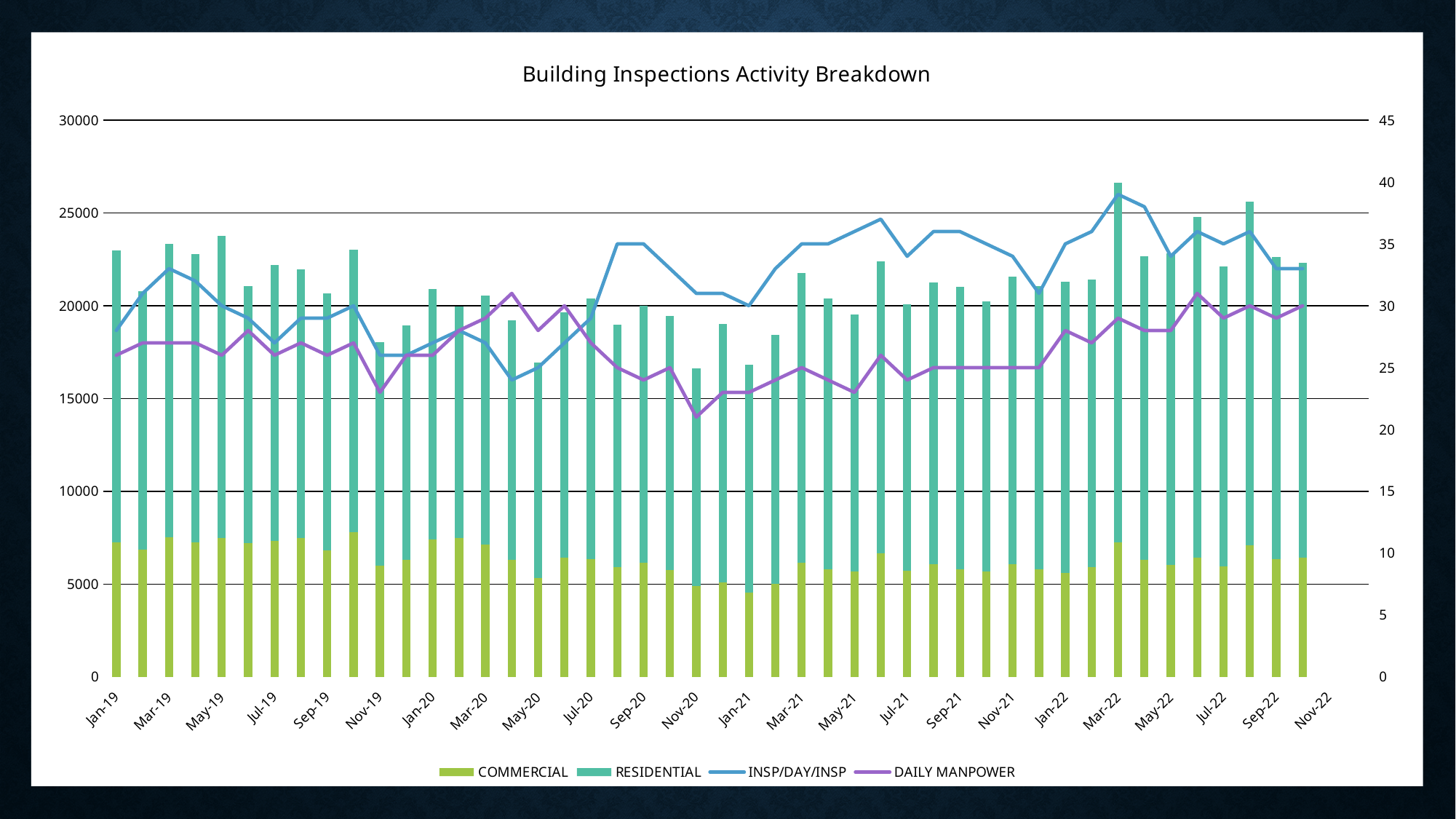
Which has the larger total stacked bar, Jan-19 or Mar-22? Mar-22 Is the total stacked bar for Nov-20 greater or less than 20000? less How many series does the legend list? 4 Which series are shown as lines rather than bars? INSP/DAY/INSP and DAILY MANPOWER What kind of chart is this? Combined stacked bar and line chart In which month is the total stacked bar (Commercial plus Residential) the highest? Mar-22 Is the total stacked bar for Mar-22 greater or less than 25000? greater Is the DAILY MANPOWER value for Nov-20 greater or less than 25? less Does the INSP/DAY/INSP line generally rise or fall from Jan-19 to the end of the chart? rise What is the title of the chart? Building Inspections Activity Breakdown